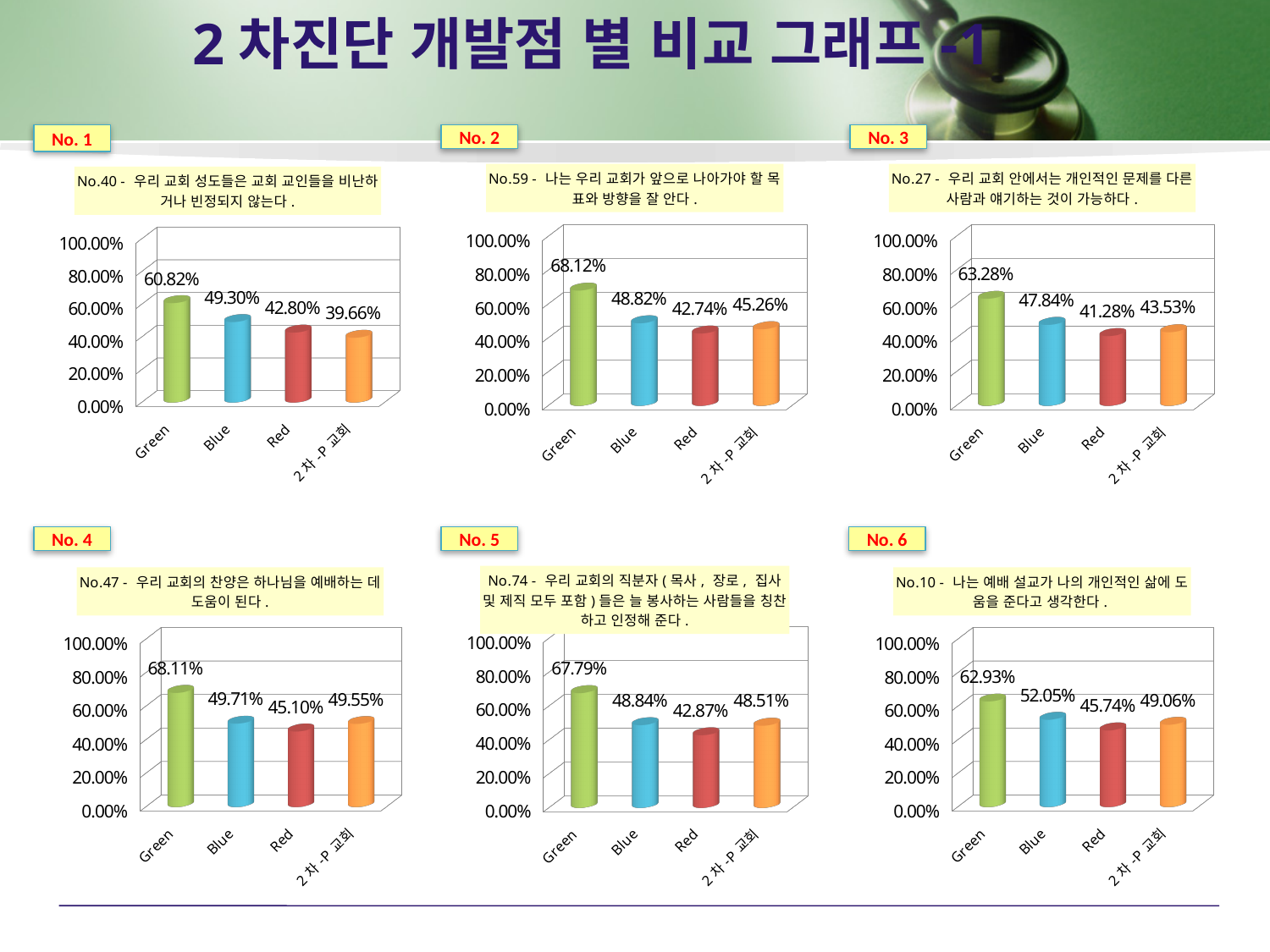
In chart No. 1, what is the value for Green? 60.82% In chart No. 2, what is the value for Red? 42.74% In chart No. 1, which category has the lowest value? 2차-P 교회 In chart No. 2, what is the difference between the Green value and the Blue value? 19.30 percentage points In chart No. 3, which is larger, the value for Red or the value for 2차-P 교회? 2차-P 교회 In chart No. 3, which category has the highest value? Green What kind of chart is chart No. 5? Bar chart In chart No. 6, what is the difference between the Green value and the Red value? 17.19 percentage points How many categories are shown in chart No. 4? 4 In chart No. 6, what is the value for Blue? 52.05% In chart No. 5, what is the value for Blue? 48.84% In chart No. 4, what is the value for 2차-P 교회? 49.55%